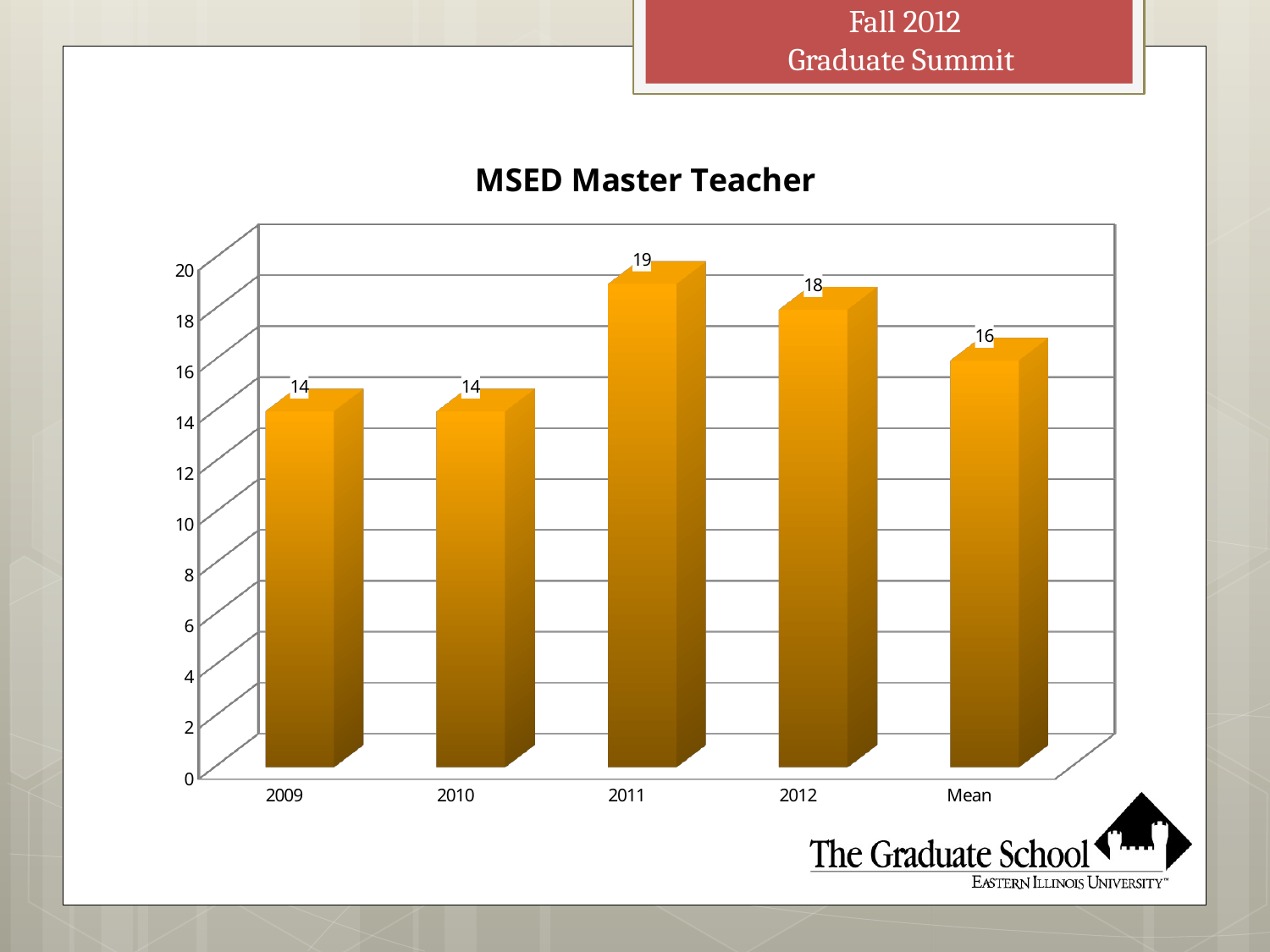
What is the Mean value shown in the MSED Master Teacher chart? 16 What is the title of the chart? MSED Master Teacher Is the value for 2011 greater or less than 18? greater How many categories are shown on the x axis of the chart? 5 What is the value for 2011 in the MSED Master Teacher chart? 19 Which category has the highest value in the MSED Master Teacher chart? 2011 What is the difference between the value for 2012 and the Mean? 2 What kind of chart is shown on the slide? bar chart What is the value for 2009 in the MSED Master Teacher chart? 14 Do the values rise or fall from 2010 to 2011? rise Which is larger, the value for 2010 or the value for 2012? 2012 What is the difference between the values for 2011 and 2012? 1